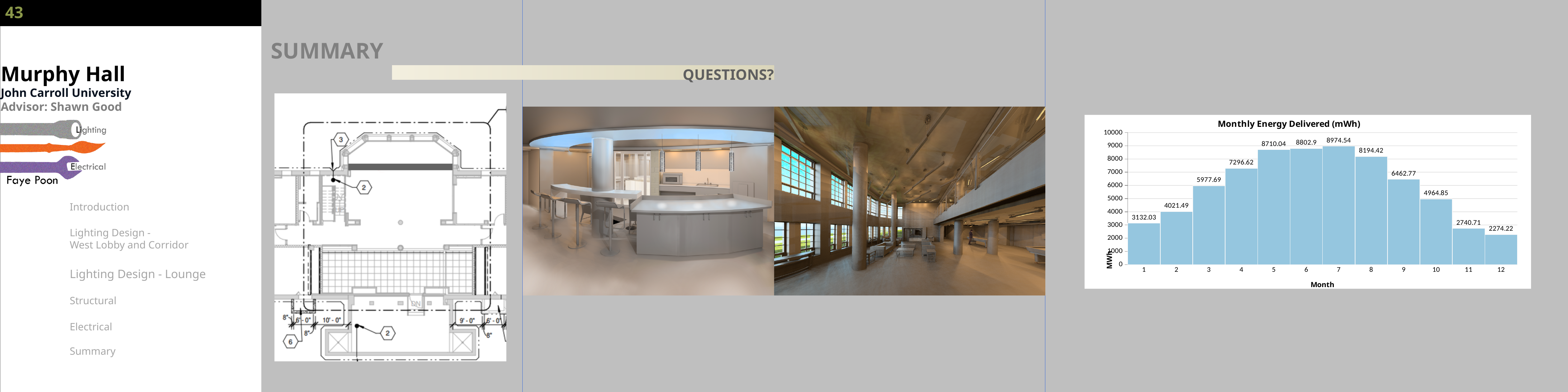
Do the values in the Monthly Energy Delivered chart rise or fall from month 7 to month 12? fall How many months are plotted in the Monthly Energy Delivered chart? 12 What is the value for month 7 in the Monthly Energy Delivered chart? 8974.54 What is the value for month 1 in the Monthly Energy Delivered chart? 3132.03 What kind of chart is shown on the slide? bar chart What is the title of the chart on the slide? Monthly Energy Delivered (mWh) What is the value for month 10 in the Monthly Energy Delivered chart? 4964.85 Which is larger in the Monthly Energy Delivered chart, the value for month 3 or the value for month 9? month 9 Is the value for month 4 in the Monthly Energy Delivered chart greater or less than 7000? greater Which month has the lowest value in the Monthly Energy Delivered chart? 12 What is the difference between the values for month 7 and month 12 in the Monthly Energy Delivered chart? 6700.32 Which month has the highest value in the Monthly Energy Delivered chart? 7